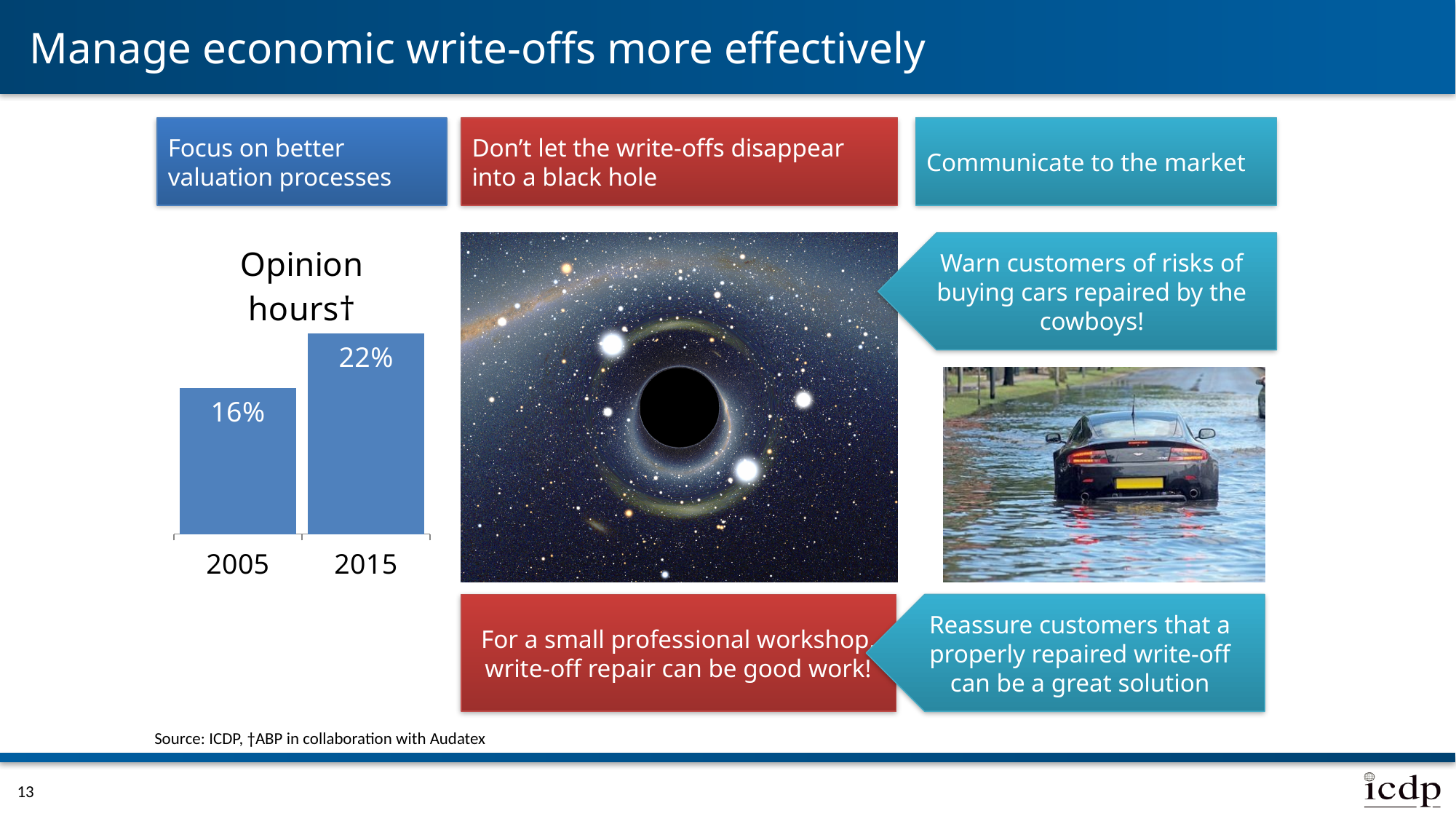
How many categories are shown in the Opinion hours chart? 2 What is the value for 2015 in the Opinion hours chart? 22% Which year has the lower value in the Opinion hours chart? 2005 Which year has the higher value in the Opinion hours chart? 2015 Do the values in the Opinion hours chart rise or fall from 2005 to 2015? Rise Is the value for 2005 or 2015 larger in the Opinion hours chart? 2015 What is the title of the chart on the slide? Opinion hours† What kind of chart is the Opinion hours chart? Bar chart What is the difference between the 2015 and 2005 values in the Opinion hours chart? 6% What is the value for 2005 in the Opinion hours chart? 16% What colour are the bars in the Opinion hours chart? Blue